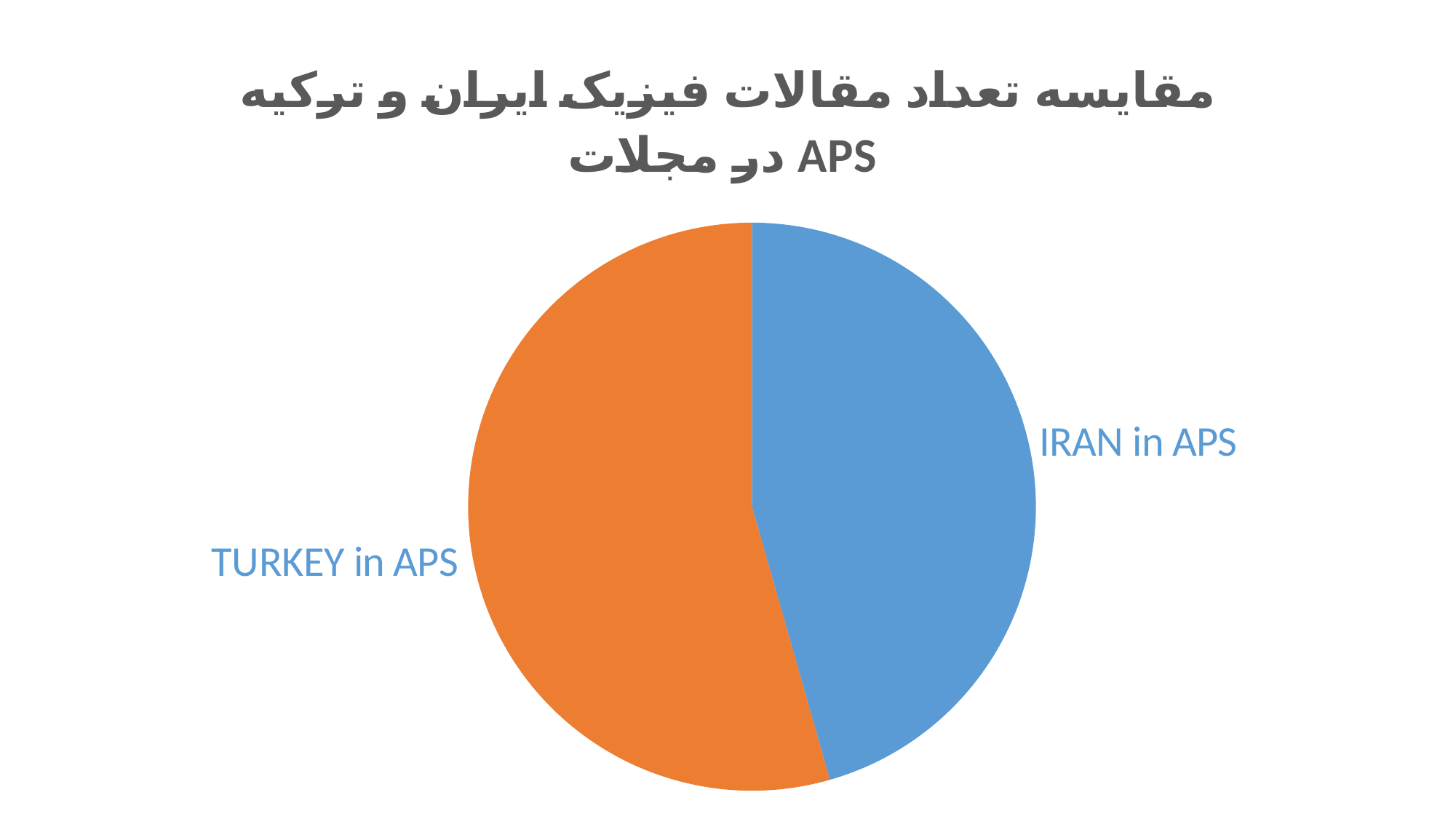
How many slices does the pie chart have? 2 What kind of chart is shown on the slide? pie chart Which slice is larger, IRAN in APS or TURKEY in APS? TURKEY in APS Which slice of the pie chart is the smallest? IRAN in APS Which slice of the pie chart is the largest? TURKEY in APS Does the IRAN in APS slice take up more or less than half of the pie? less What colour is the TURKEY in APS slice? orange Does the TURKEY in APS slice take up more or less than half of the pie? more What colour is the IRAN in APS slice? blue